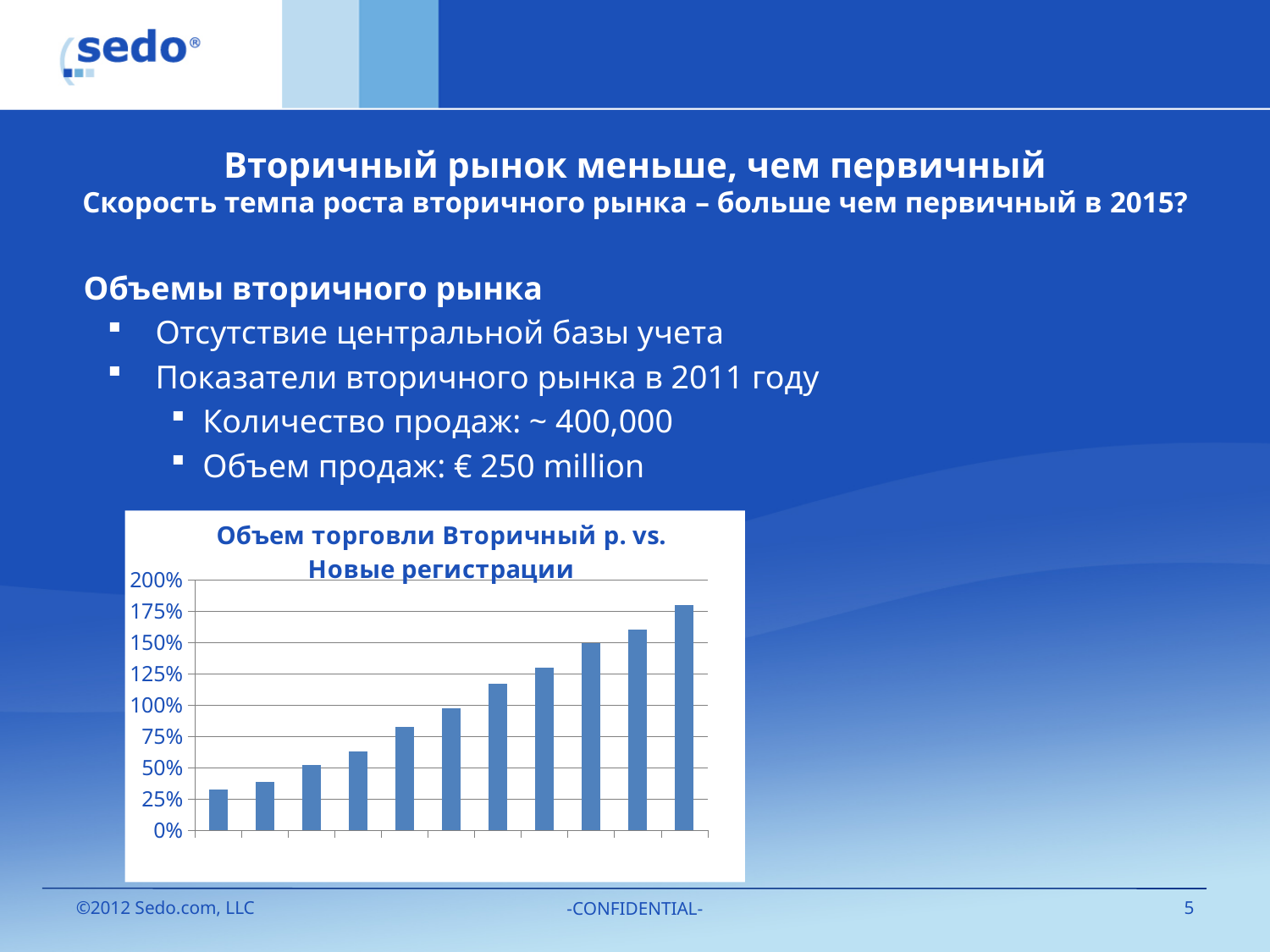
Is the value of the first (leftmost) bar greater or less than 50%? less Is the value of the seventh bar from the left greater or less than 100%? greater Which bar is the lowest in the chart? the leftmost (first) bar Is the value of the tenth bar from the left greater or less than 150%? greater How many bars are plotted in the chart? 11 Which bar is the highest in the chart? the rightmost (last) bar What kind of chart is shown on the slide? bar chart Do the bar values rise or fall from left to right along the x axis? rise What is the highest value shown on the y axis of the chart? 200% Which is larger, the value of the third bar or the value of the eighth bar? the eighth bar What is the title of the chart? Объем торговли Вторичный р. vs. Новые регистрации